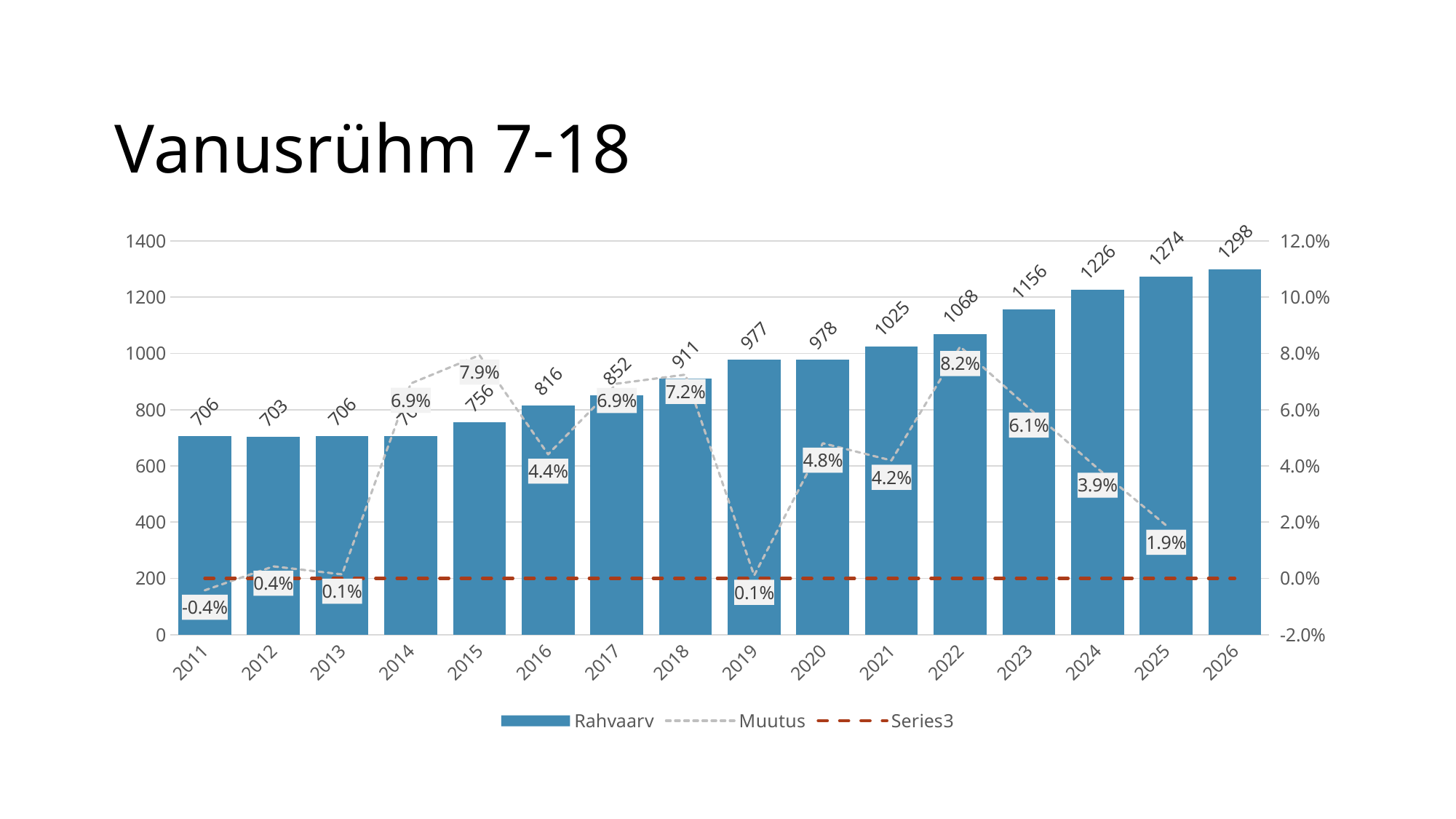
Is the Rahvaarv value for 2023 greater or less than 1000? greater How many years are shown on the x axis? 16 How many series does the legend list? 3 Which year has the highest Rahvaarv value? 2026 What is the highest Muutus percentage labelled on the chart? 8.2% What is the Rahvaarv value for 2021? 1025 What is the difference between the Rahvaarv values for 2026 and 2011? 592 What is the Rahvaarv value for 2018? 911 What is the difference between the Rahvaarv values for 2025 and 2024? 48 What is the Rahvaarv value for 2026? 1298 Which year has the lowest Rahvaarv value? 2012 Which year has the larger Rahvaarv value, 2015 or 2016? 2016